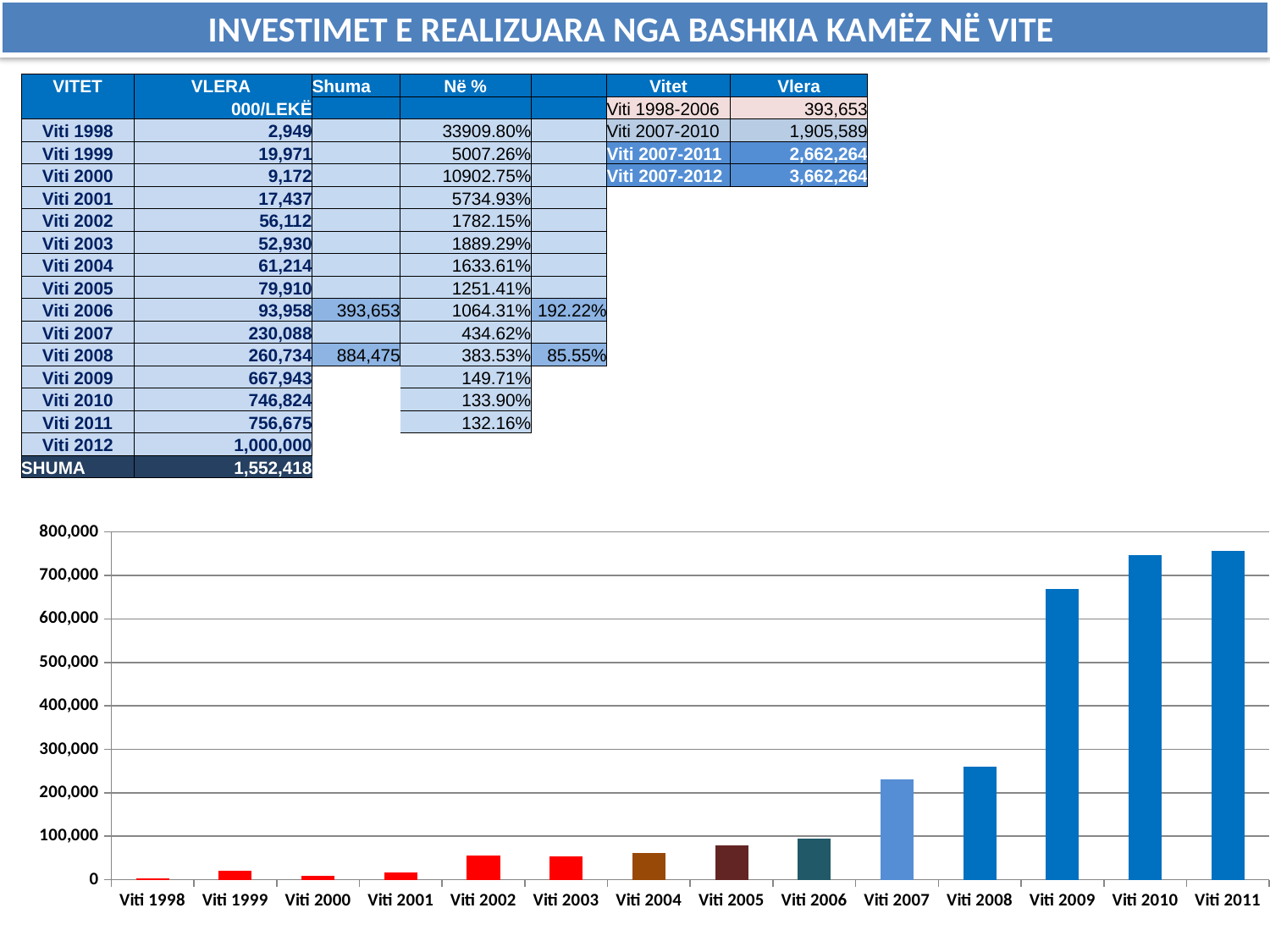
According to the table on the slide, what is the value (000/LEKË) for Viti 2009? 667,943 Do the bar values generally rise or fall from Viti 1998 to Viti 2011? Rise Is the bar for Viti 2006 greater or less than 100,000? less Is the bar for Viti 2007 greater or less than 200,000? greater How many years (bars) are plotted in the bar chart? 14 Which bar is taller, Viti 2009 or Viti 2008? Viti 2009 Which year has the lowest bar in the chart? Viti 1998 What kind of chart is shown at the bottom of the slide? Bar chart Is the bar for Viti 2008 greater or less than 300,000? less Using the table values, what is the difference between Viti 2009 (667,943) and Viti 2008 (260,734)? 407,209 What is the title of the slide containing the chart? INVESTIMET E REALIZUARA NGA BASHKIA KAMËZ NË VITE